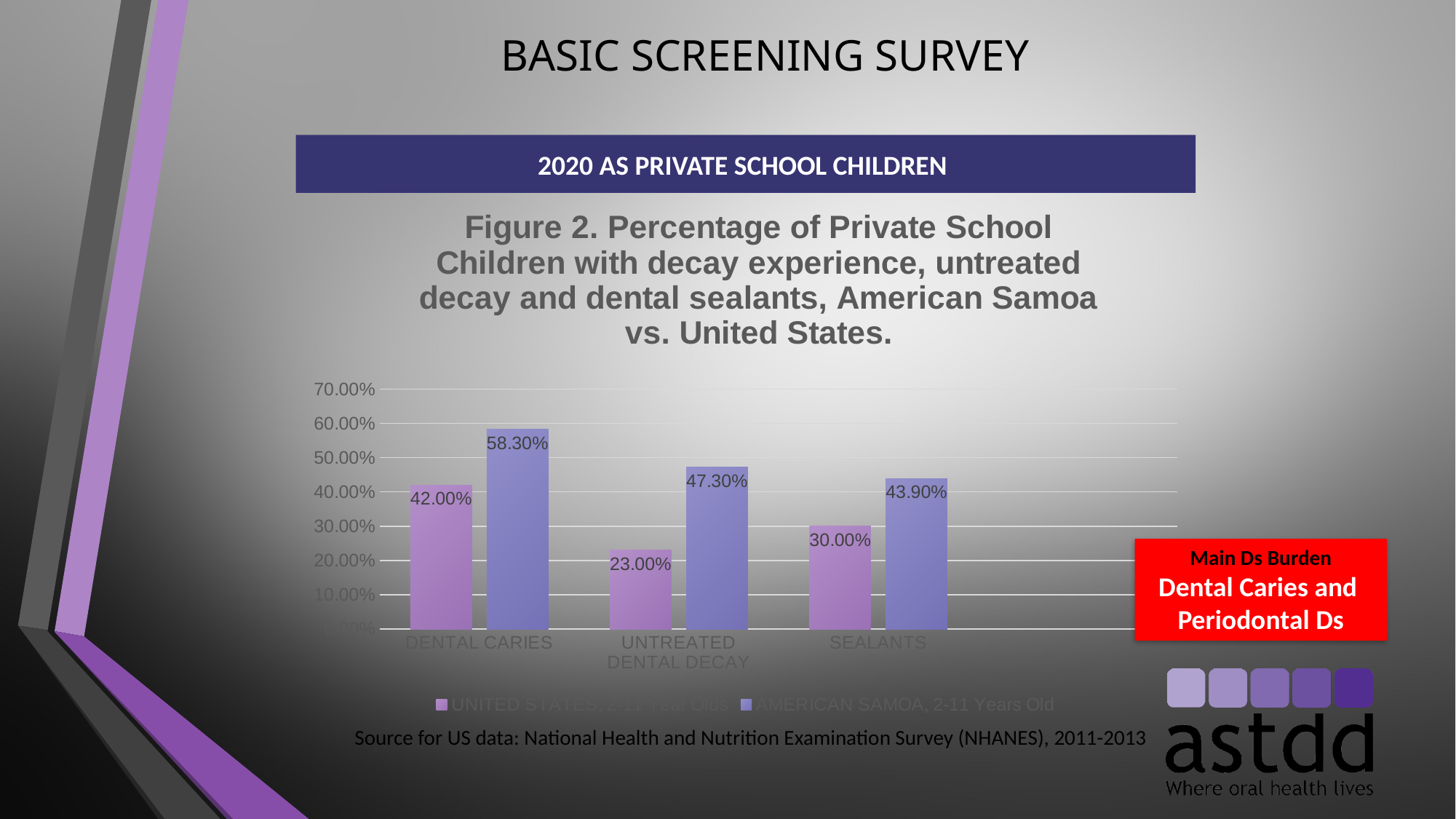
What is the difference between the American Samoa and United States values for Untreated Dental Decay? 24.30% What kind of chart is shown on the slide? Bar chart How many series does the legend list? 2 Which category has the lowest value for United States, 2-11 Year Olds? Untreated Dental Decay What is the difference between the American Samoa and United States values for Dental Caries? 16.30% How many categories are shown on the x axis? 3 What is the value for American Samoa, 2-11 Years Old in the Dental Caries category? 58.30% What is the value for United States, 2-11 Year Olds in the Untreated Dental Decay category? 23.00% What is the value for American Samoa, 2-11 Years Old in the Sealants category? 43.90% Which is larger for Sealants: the United States value or the American Samoa value? American Samoa Which category has the highest value for American Samoa, 2-11 Years Old? Dental Caries What is the value for United States, 2-11 Year Olds in the Sealants category? 30.00%